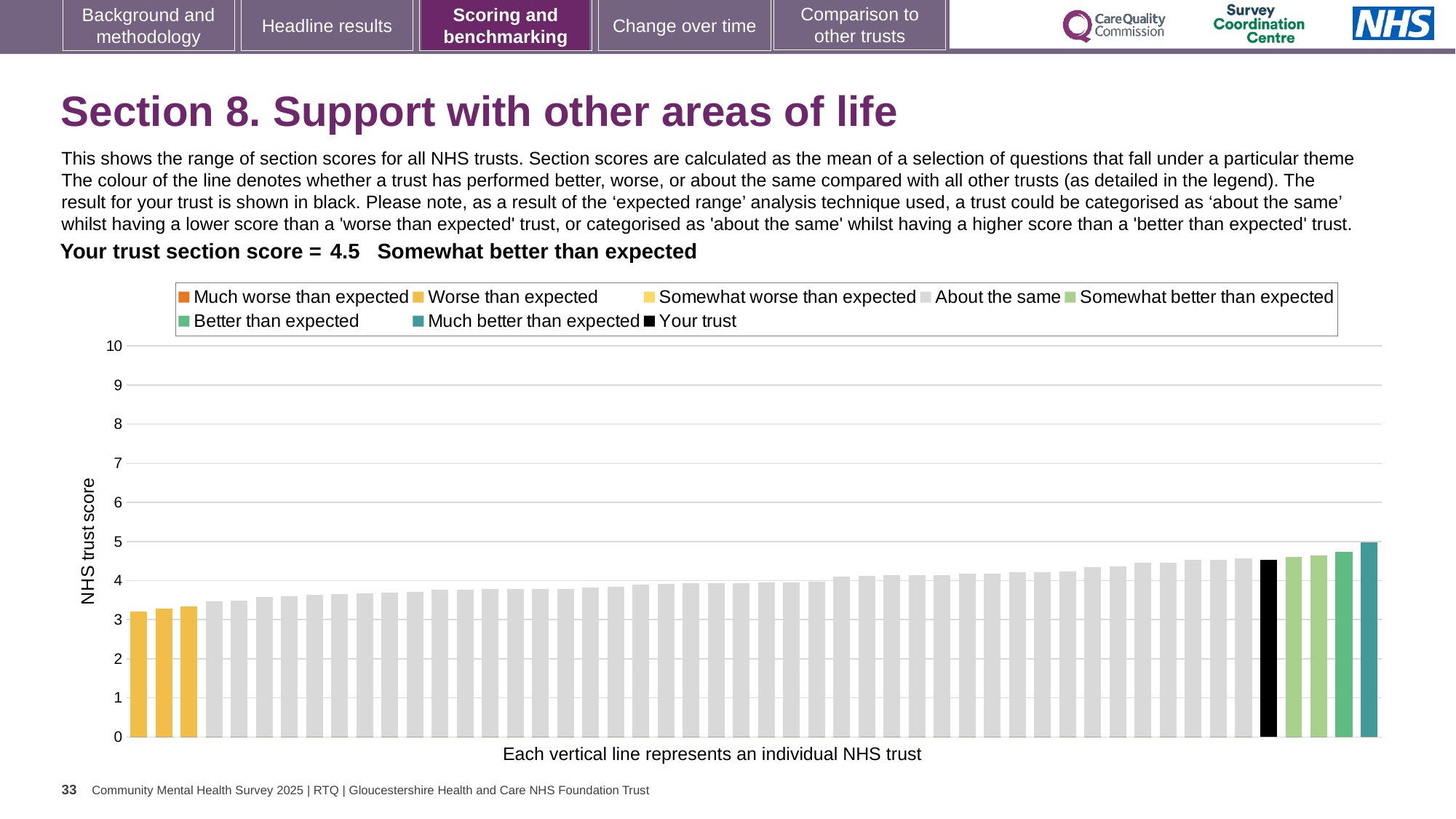
What colour is used for the 'Your trust' bar in the chart? Black Is the value of the highest bar in the chart greater or less than 6? less Is the value of the lowest bar in the chart greater or less than 4? less Do the bar values rise or fall from left to right along the x axis? Rise Is the value of the black 'Your trust' bar greater or less than 4? greater How many bars are coloured as 'Worse than expected' (yellow)? 3 What is the label on the vertical axis of the chart? NHS trust score Which category does your trust's section score fall into, according to the slide? Somewhat better than expected What kind of chart is shown on the slide? Bar chart What is the section score for your trust shown on the slide? 4.5 How many entries does the chart legend list? 8